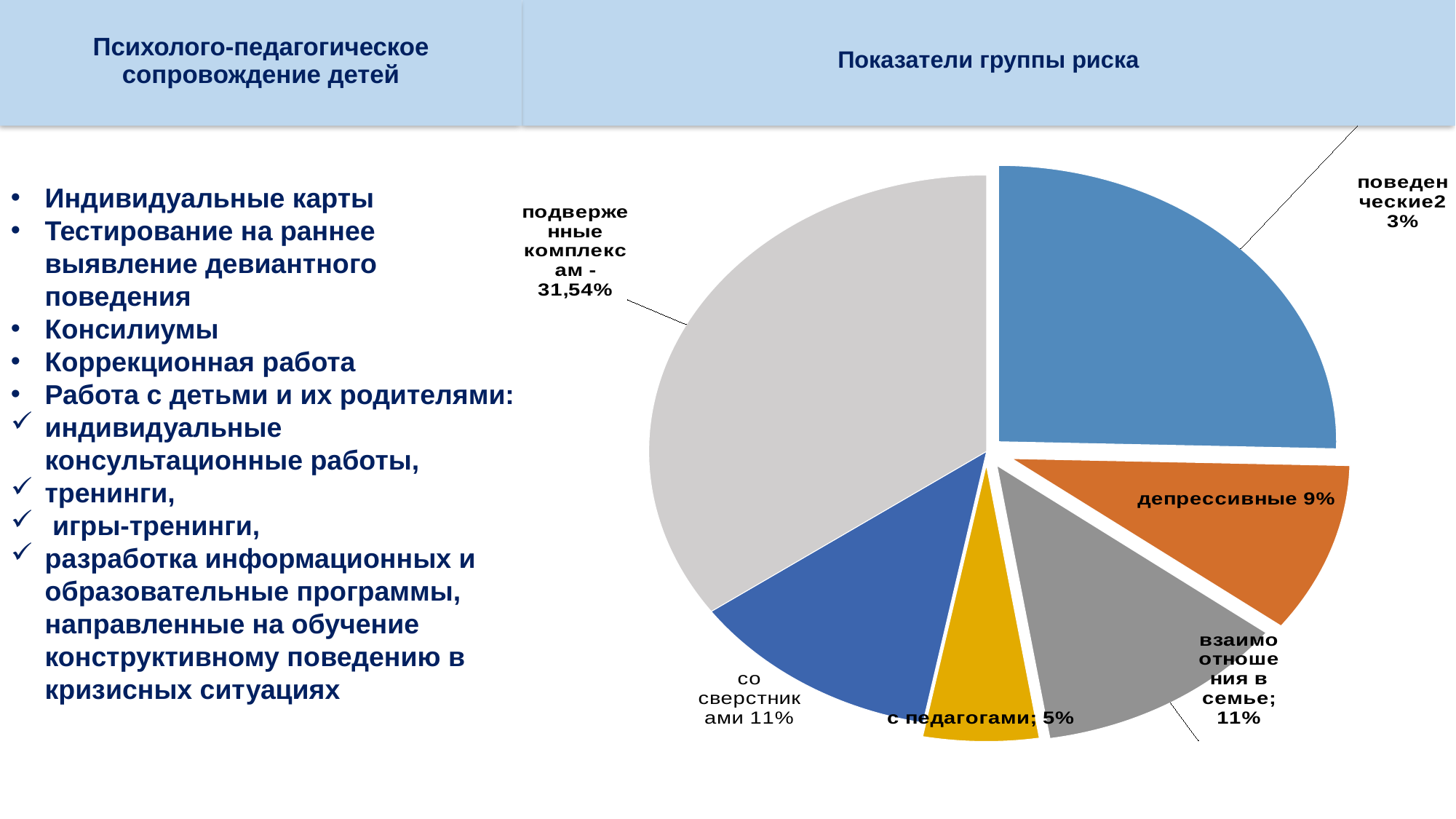
What percentage is shown for «подверженные комплексам»? 31,54% Which is larger: the slice for «депрессивные» or the slice for «с педагогами»? депрессивные What percentage is shown for «с педагогами»? 5% Which category has the smallest slice of the pie? с педагогами What percentage is shown for «депрессивные»? 9% Which category has the largest slice of the pie? подверженные комплексам What kind of chart is shown under the heading «Показатели группы риска»? pie chart What percentage is shown for «со сверстниками»? 11% What colour is the slice for «с педагогами»? yellow What percentage is shown for «взаимоотношения в семье»? 11% How many slices does the pie chart have? 6 What is the title of the chart on the slide? Показатели группы риска